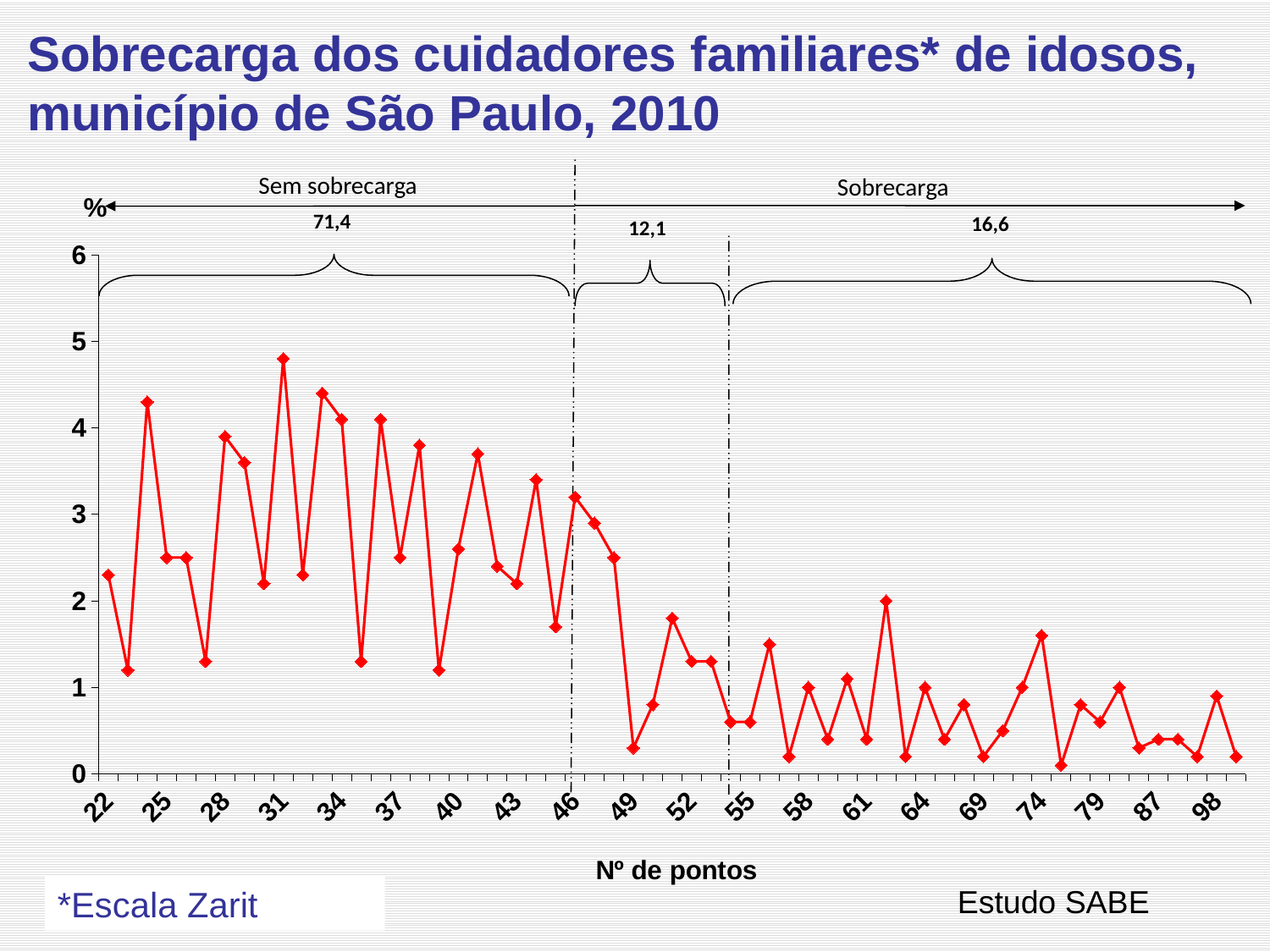
How many labels are shown on the x axis? 20 Is the value at 49 points greater or less than 1? less What is the title of the x axis? Nº de pontos Overall, do the plotted values rise or fall as the number of points increases along the x axis? fall What percentage is printed above the 'Sem sobrecarga' section of the chart? 71,4 Which is larger, the value at 31 points or the value at 49 points? 31 points Is the value at 31 points greater or less than 4? greater At which number of points does the line reach its highest value? 31 Is the value at 22 points greater or less than 2? greater What kind of chart is shown on the slide? line chart